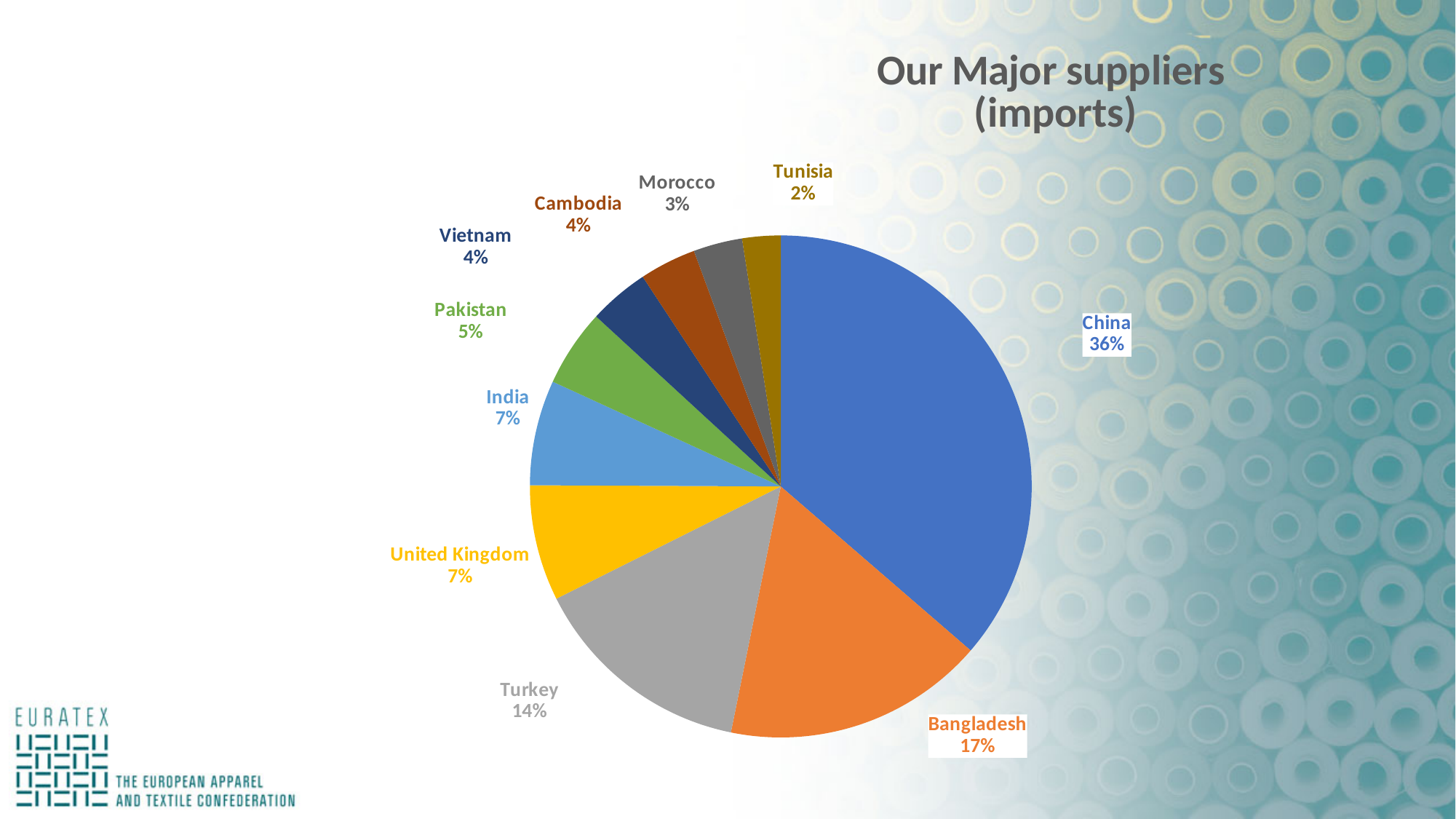
What share of imports comes from Pakistan? 5% What is the title of the chart? Our Major suppliers (imports) Which has a larger share of imports, Turkey or Bangladesh? Bangladesh What share of imports comes from Bangladesh? 17% How many suppliers are shown in the pie chart? 10 What share of imports comes from China? 36% What is the difference in share between Turkey and India? 7% What share of imports comes from Turkey? 14% What type of chart is shown on the slide? Pie chart Which supplier has the smallest share of imports? Tunisia What is the difference in share between China and Bangladesh? 19% Which supplier has the largest share of imports? China